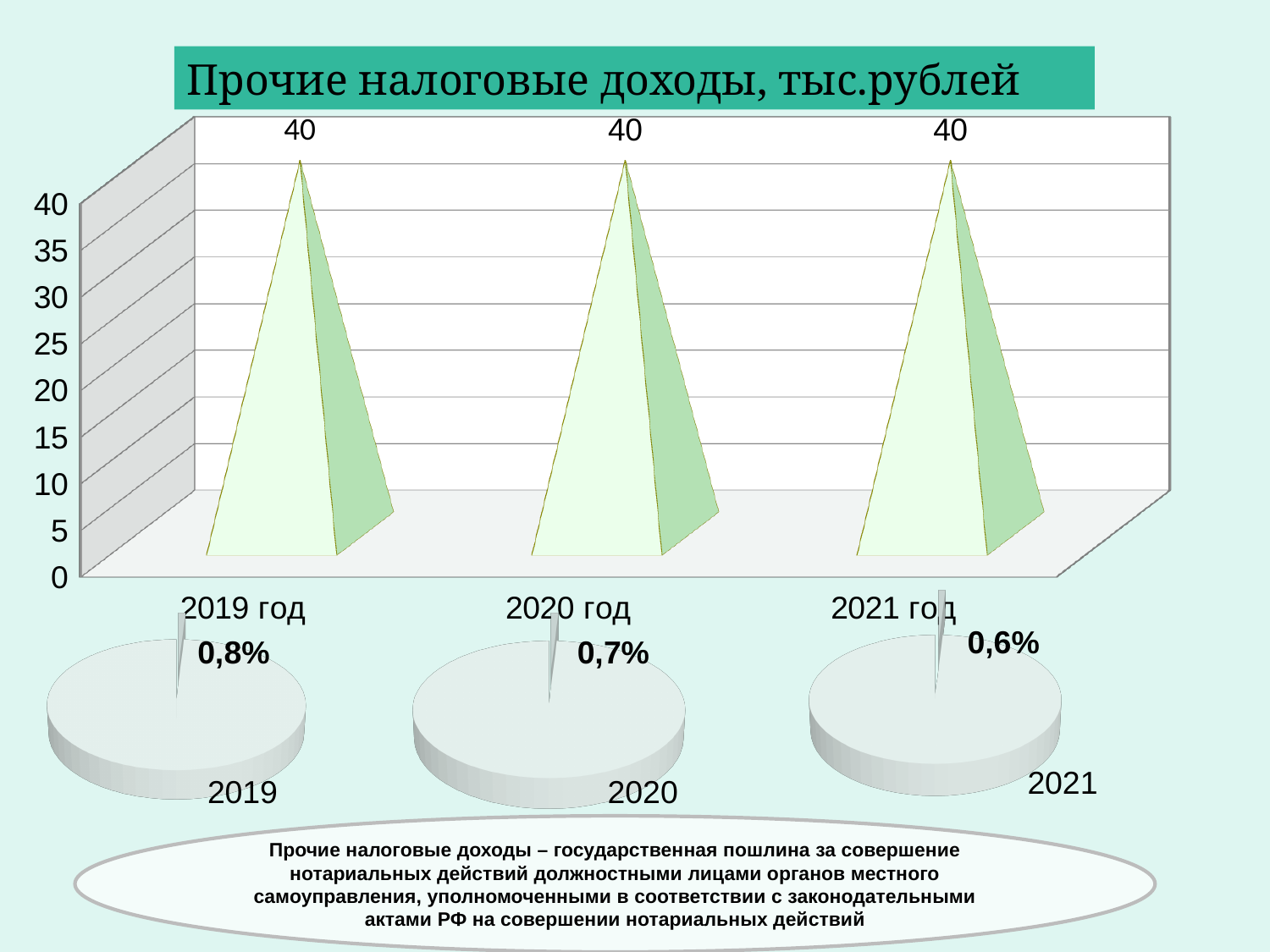
In the chart titled 'Прочие налоговые доходы, тыс.рублей', what is the value for 2021 год? 40 In the chart titled 'Прочие налоговые доходы, тыс.рублей', how many categories are plotted? 3 In the chart titled 'Прочие налоговые доходы, тыс.рублей', what is the value for 2020 год? 40 In the pie chart labelled 2021 at the bottom right of the slide, what share is shown for the highlighted slice? 0,6% In the chart titled 'Прочие налоговые доходы, тыс.рублей', is the value for 2020 год greater or less than 30? greater In the pie chart labelled 2020 at the bottom centre of the slide, what share is shown for the highlighted slice? 0,7% How many pie charts are shown at the bottom of the slide? 3 In the chart titled 'Прочие налоговые доходы, тыс.рублей', do the values rise, fall or stay the same from 2019 год to 2021 год? stay the same In the pie chart labelled 2019 at the bottom left of the slide, what share is shown for the highlighted slice? 0,8% What is the title of the top chart on the slide? Прочие налоговые доходы, тыс.рублей In the chart titled 'Прочие налоговые доходы, тыс.рублей', what is the difference between the values for 2019 год and 2021 год? 0 In the chart titled 'Прочие налоговые доходы, тыс.рублей', what is the value for 2019 год? 40